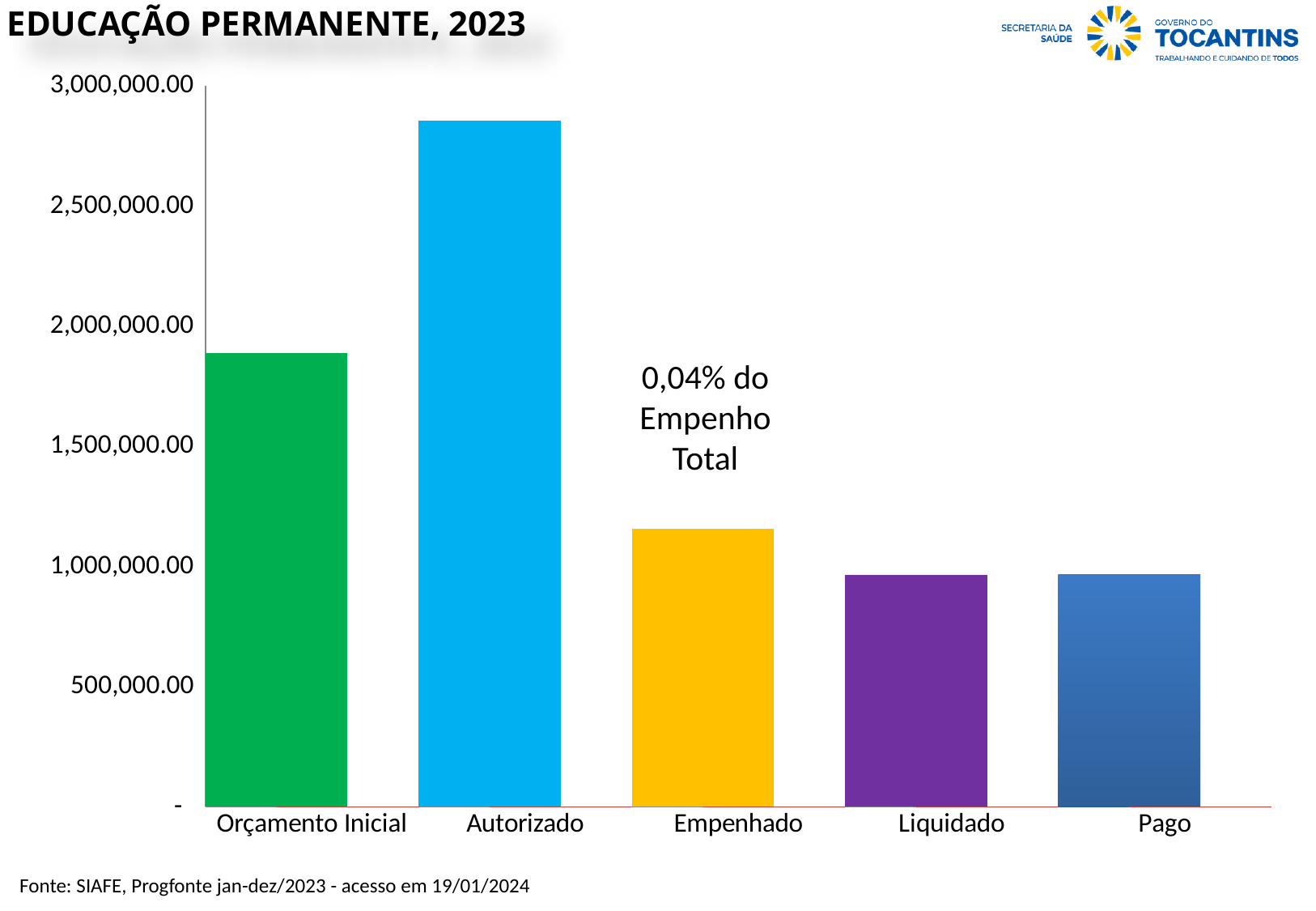
Is the value for Empenhado greater or less than 1,000,000.00? greater Is the value for Orçamento Inicial greater or less than 2,000,000.00? less Which category has the highest value? Autorizado Is the value for Liquidado greater or less than 1,000,000.00? less Which is larger, the value for Autorizado or the value for Orçamento Inicial? Autorizado What kind of chart is shown on the slide? bar chart What annotation text is shown above the Empenhado bar? 0,04% do Empenho Total Which is larger, the value for Orçamento Inicial or the value for Empenhado? Orçamento Inicial How many categories are plotted on the chart? 5 What is the title of the chart? EDUCAÇÃO PERMANENTE, 2023